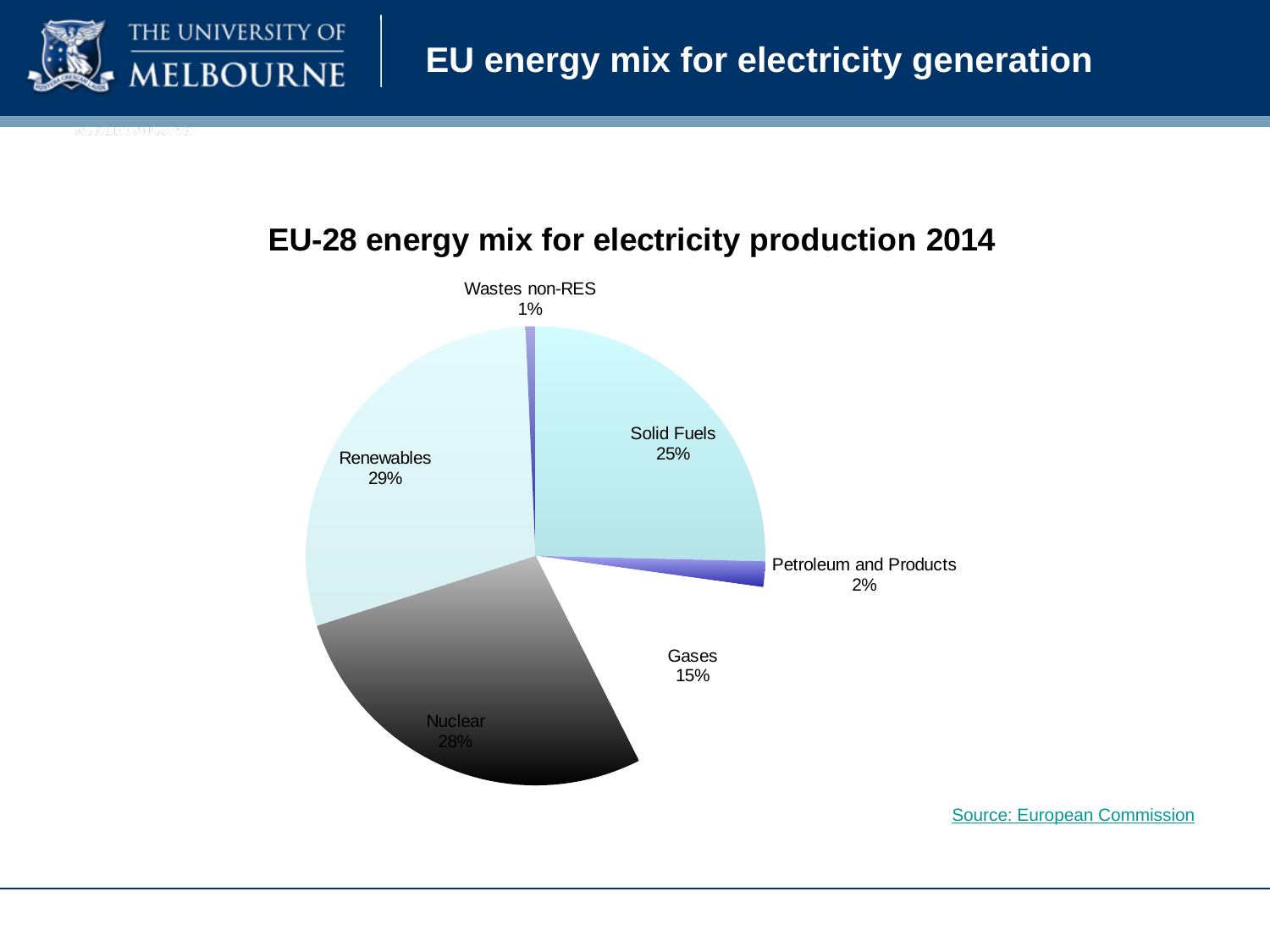
Which energy source has the smallest share of the pie? Wastes non-RES What is the title of the chart? EU-28 energy mix for electricity production 2014 What is the combined share of Renewables and Nuclear? 57% What is the difference in percentage points between the Nuclear share and the Gases share? 13 Which has a larger share, Solid Fuels or Gases? Solid Fuels Which energy source has the largest share of the pie? Renewables What share of EU-28 electricity production in 2014 came from Gases? 15% How many energy sources (slices) are shown in the pie chart? 6 What share of EU-28 electricity production in 2014 came from Petroleum and Products? 2% What kind of chart is shown on the slide? Pie chart What share of EU-28 electricity production in 2014 came from Solid Fuels? 25% What share of EU-28 electricity production in 2014 came from Renewables? 29%